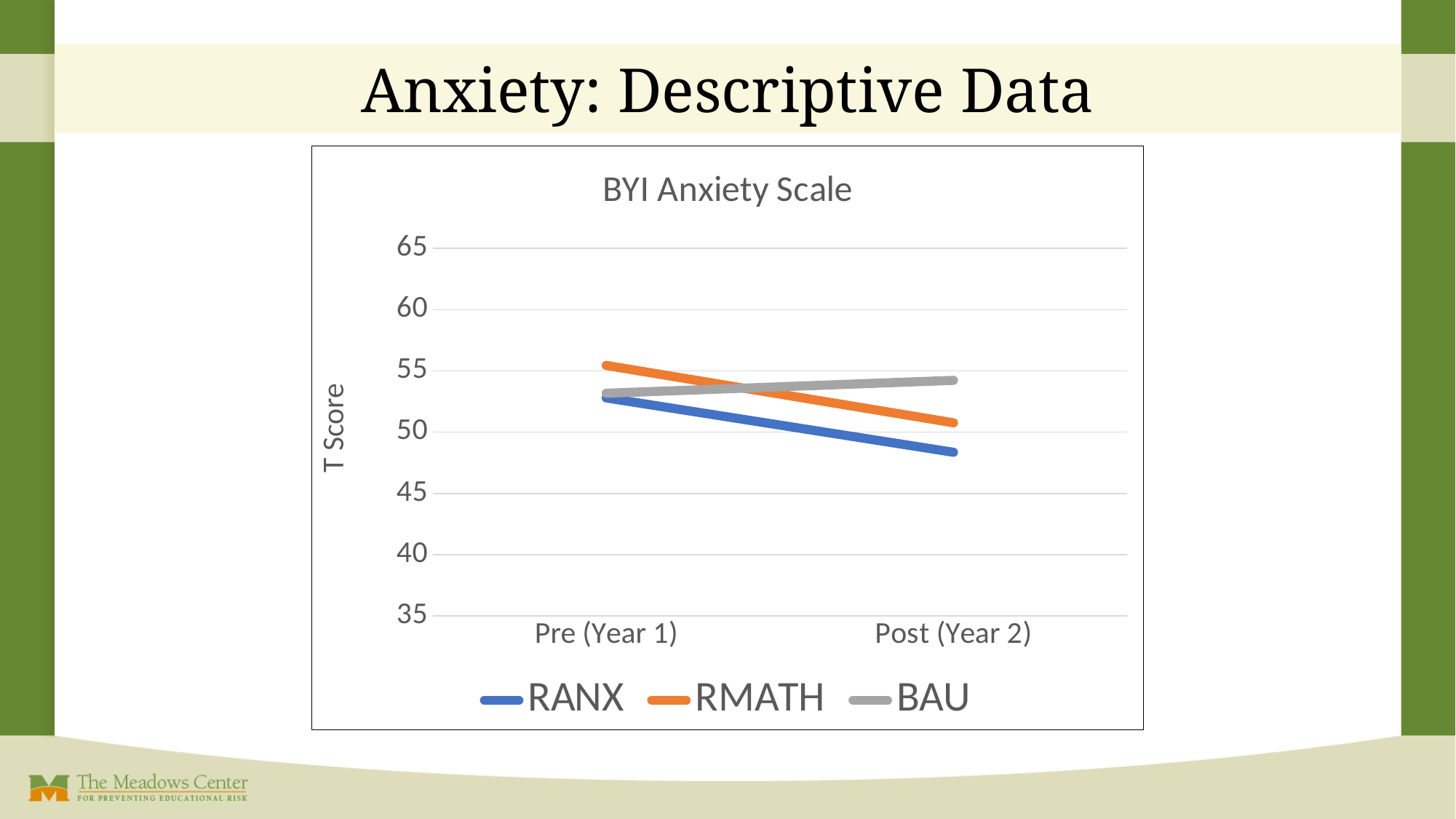
How many time points are shown on the x axis? 2 Which series has the lowest T Score at Post (Year 2)? RANX How many series does the legend list? 3 Is the RANX value at Post (Year 2) greater or less than 50? less At Post (Year 2), which is larger, the BAU value or the RANX value? BAU What is the title of the chart? BYI Anxiety Scale Which series has the highest T Score at Post (Year 2)? BAU Which series has the highest T Score at Pre (Year 1)? RMATH Does the BAU line rise or fall from Pre (Year 1) to Post (Year 2)? rise Does the RANX line rise or fall from Pre (Year 1) to Post (Year 2)? fall Does the RMATH line rise or fall from Pre (Year 1) to Post (Year 2)? fall What kind of chart is shown on the slide? line chart